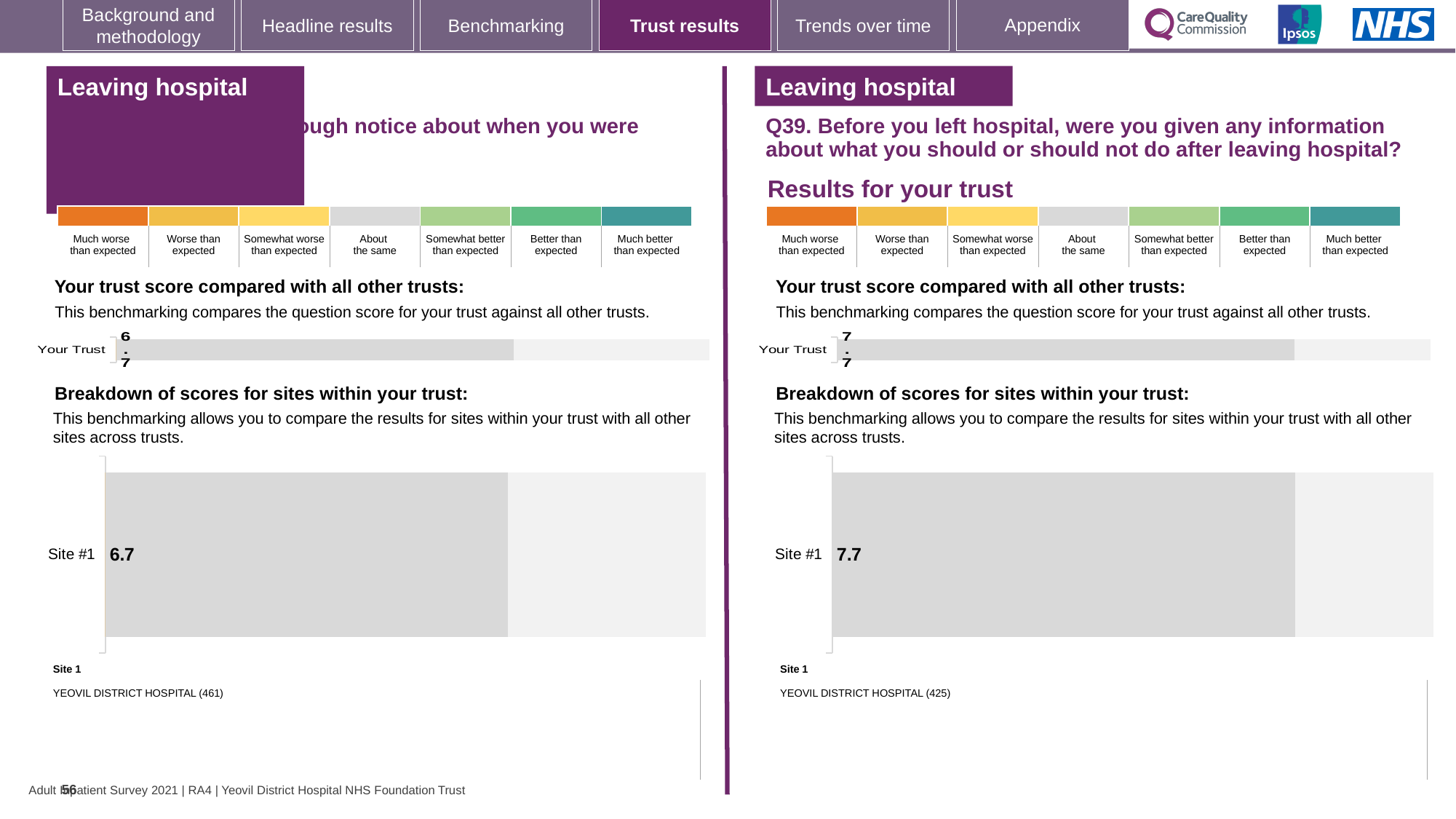
How many sites are shown in the 'Breakdown of scores for sites within your trust' chart on the left-hand side? 1 On the right-hand side of the slide (Q39), what is the score shown for Your Trust in the 'Your trust score compared with all other trusts' chart? 7.7 On the left-hand side of the slide, what is the score shown for Your Trust in the 'Your trust score compared with all other trusts' chart? 6.7 On the left-hand side of the slide, what is the score shown for Site #1 in the 'Breakdown of scores for sites within your trust' chart? 6.7 On the right-hand side (Q39), which site name is listed as Site 1 below the breakdown chart? YEOVIL DISTRICT HOSPITAL (425) What is the difference between the Site #1 score on the right-hand (Q39) chart and the Site #1 score on the left-hand chart? 1.0 What kind of chart is used to show the Your Trust score on the left-hand side? Bar chart On the left-hand side, which site name is listed as Site 1 below the breakdown chart? YEOVIL DISTRICT HOSPITAL (461) On the right-hand side of the slide (Q39), what is the score shown for Site #1 in the 'Breakdown of scores for sites within your trust' chart? 7.7 Which is larger: the Site #1 score on the left-hand chart or the Site #1 score on the right-hand (Q39) chart? Right-hand (Q39) chart What kind of chart is used to show the Site #1 score on the right-hand side (Q39)? Bar chart How many sites are shown in the 'Breakdown of scores for sites within your trust' chart on the right-hand side (Q39)? 1